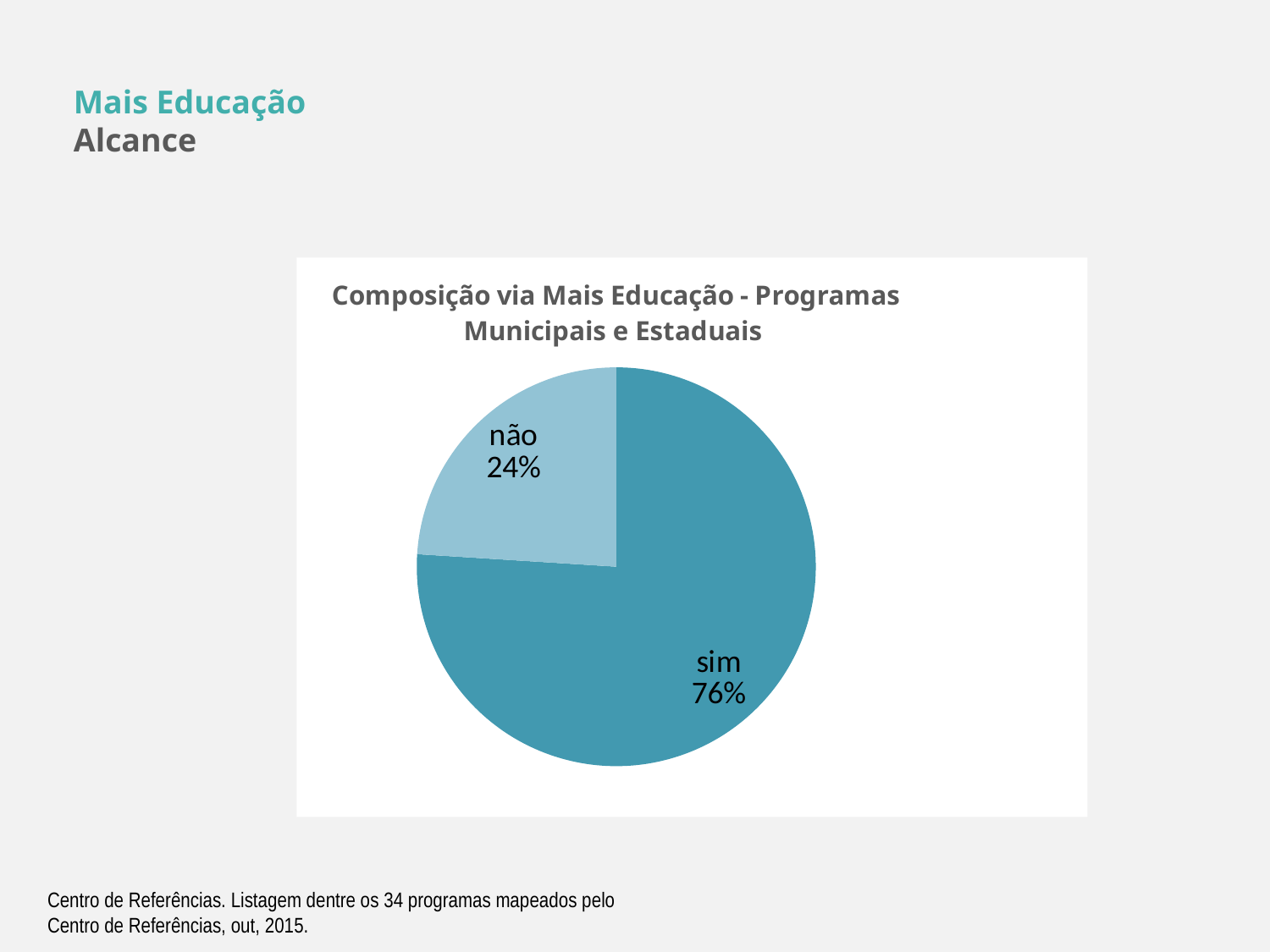
Which slice is the smallest in the pie chart? não What share of the pie does the "não" slice represent? 24% Which slice is the largest in the pie chart? sim Which is larger, the "sim" slice or the "não" slice? sim How many slices does the pie chart have? 2 What kind of chart is shown on the slide? pie chart Which slice is shown in the lighter blue colour? não What share of the pie does the "sim" slice represent? 76% What is the difference in percentage points between the "sim" and "não" slices? 52 What is the title of the chart? Composição via Mais Educação - Programas Municipais e Estaduais